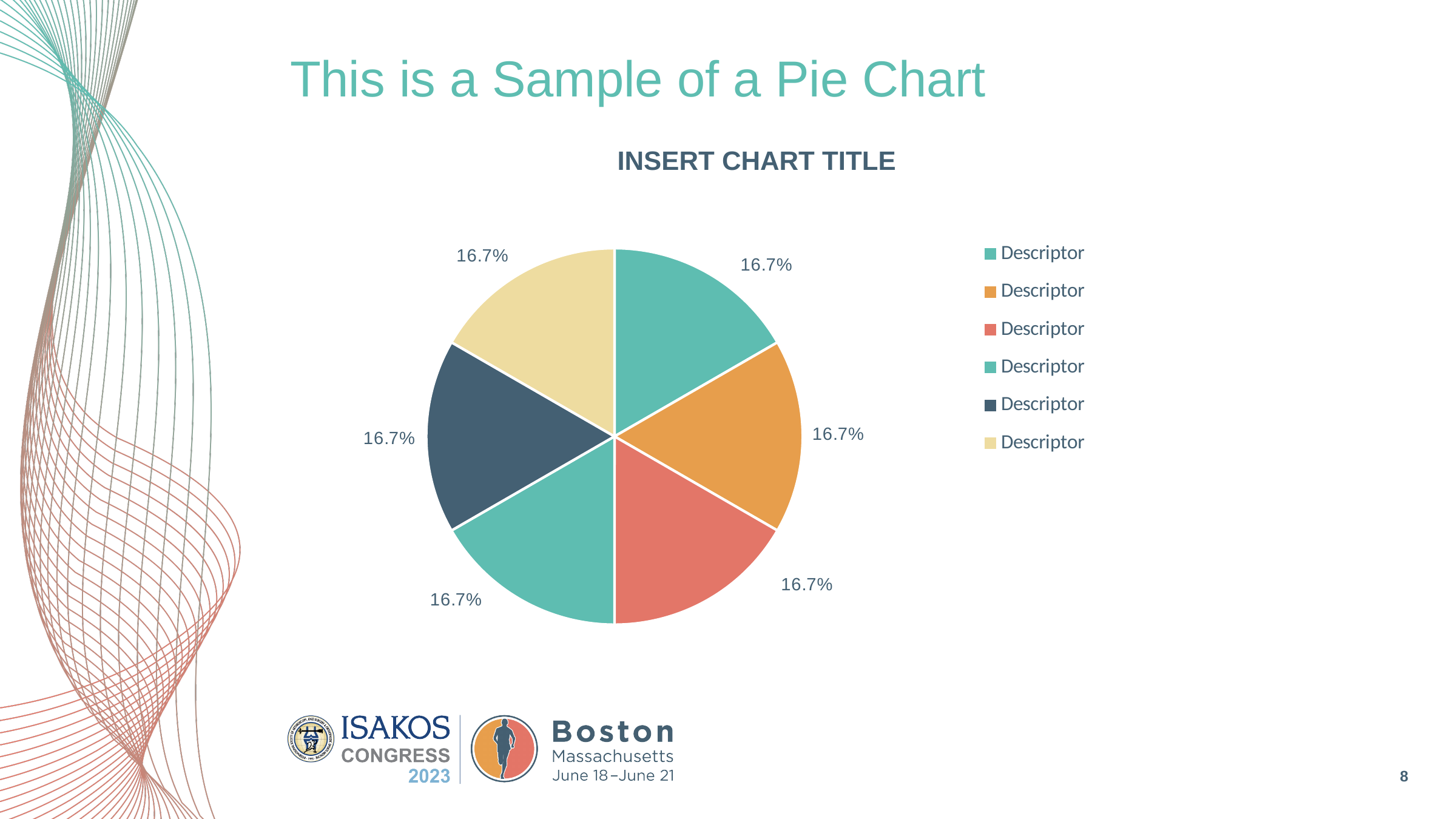
What share of the pie does the pale yellow slice represent? 16.7% What is the title of the pie chart? INSERT CHART TITLE What share of the pie does the orange slice represent? 16.7% What kind of chart is shown on the slide? pie chart Is the share of the orange slice larger than, smaller than, or equal to the share of the red slice? equal What label is used for every entry in the pie chart's legend? Descriptor How many entries does the legend of the pie chart list? 6 Is the share of the pale yellow slice greater or less than 20%? less What is the data label shown on each slice of the pie chart? 16.7% What share of the pie does the red slice represent? 16.7% How many slices does the pie chart have? 6